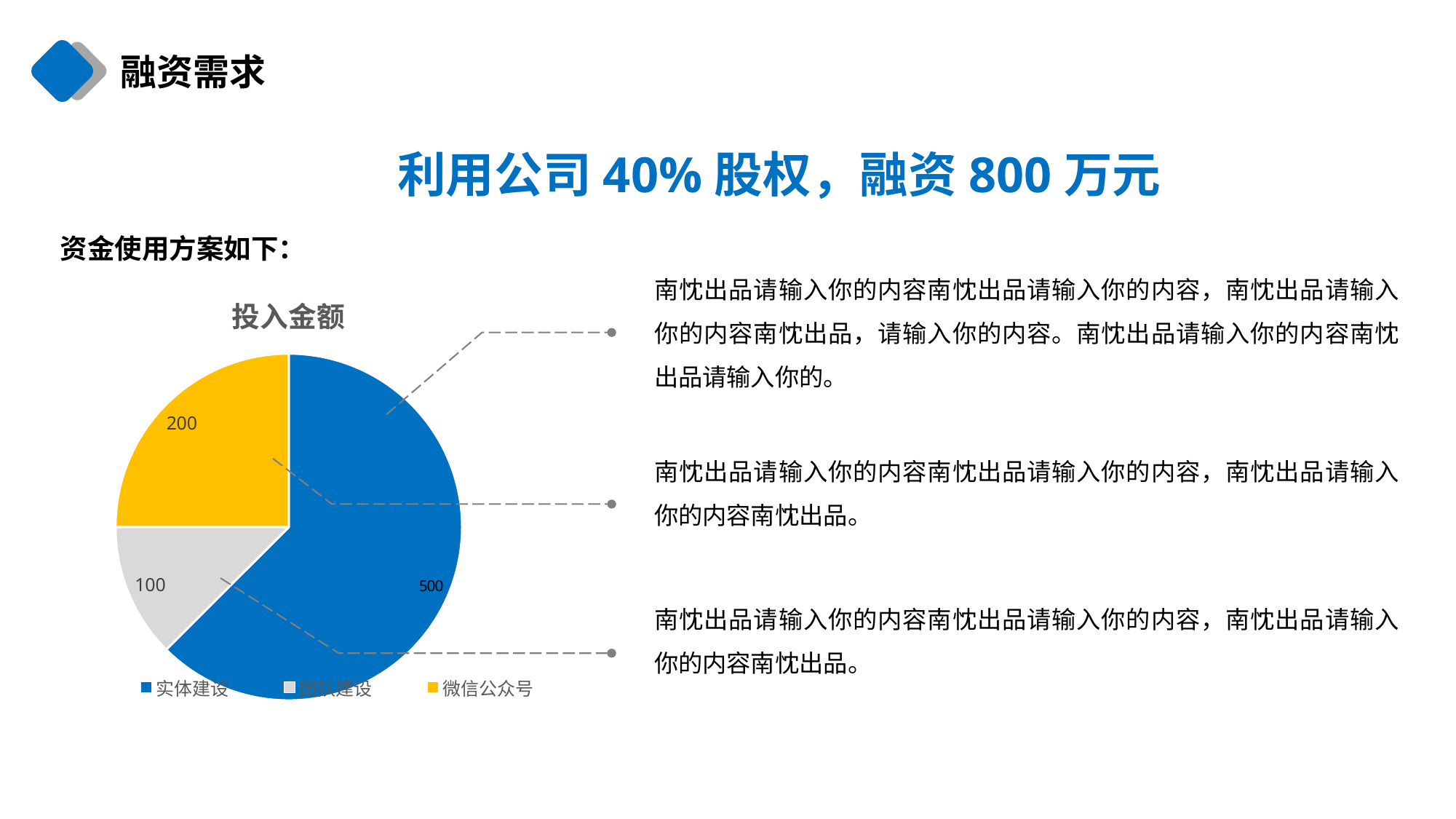
What is the total of all slices in the pie chart? 800 Which is larger, the value for 微信公众号 or the value for 团队建设? 微信公众号 What type of chart is shown on the slide? pie chart What is the value for 微信公众号 in the pie chart? 200 Which category has the largest slice in the pie chart? 实体建设 How many categories are shown in the pie chart? 3 Which category has the smallest slice in the pie chart? 团队建设 What share of the pie does 微信公众号 represent? 25% What is the difference between the values for 实体建设 and 微信公众号? 300 What is the value for 实体建设 in the pie chart? 500 What is the value for 团队建设 in the pie chart? 100 What is the title of the chart? 投入金额